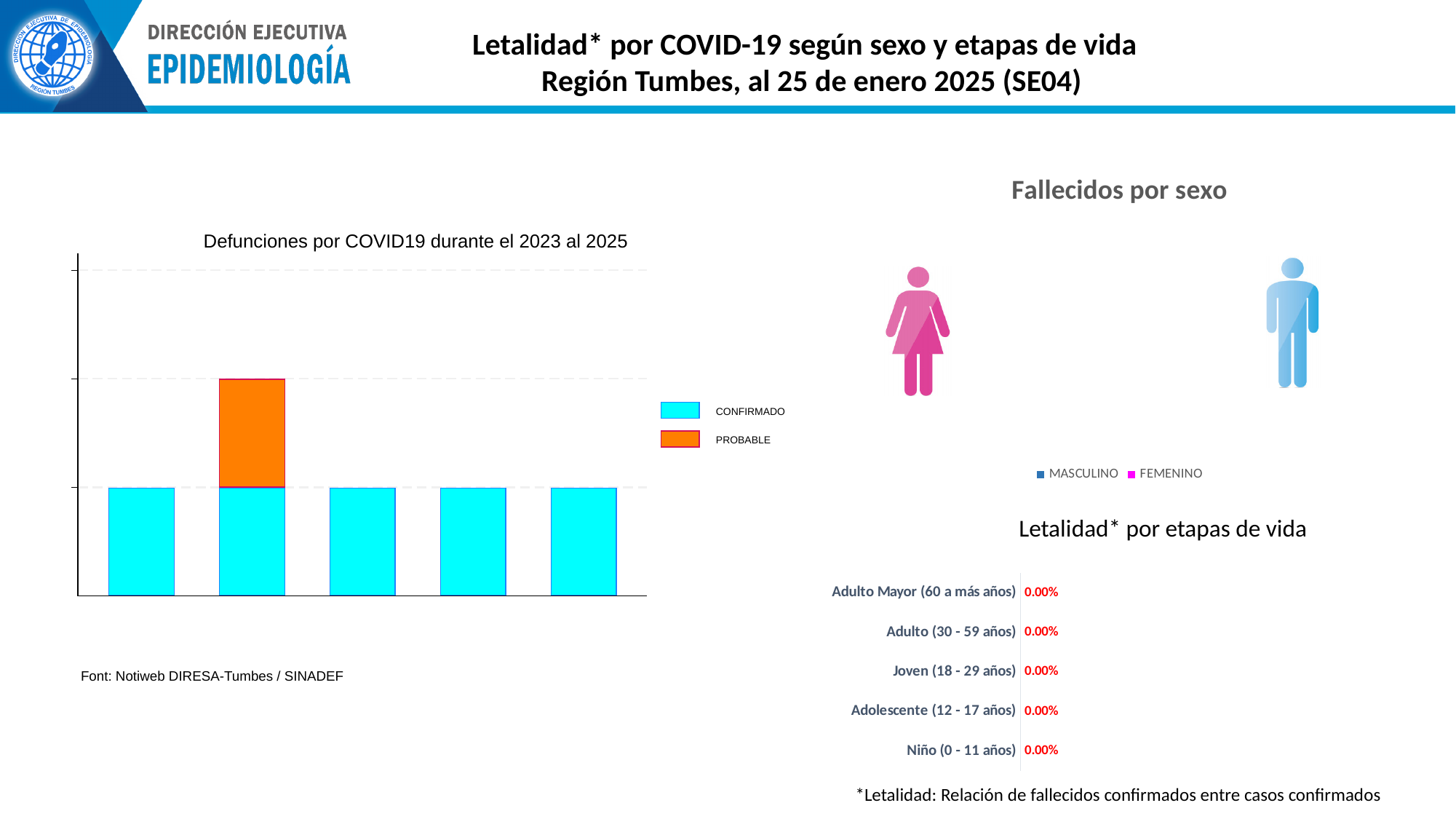
In the chart titled "Letalidad* por etapas de vida", what is the value for Adulto Mayor (60 a más años)? 0.00% In the chart titled "Defunciones por COVID19 durante el 2023 al 2025", which series is shown in orange? PROBABLE In the chart titled "Fallecidos por sexo", how many series does the legend list? 2 In the chart titled "Defunciones por COVID19 durante el 2023 al 2025", how many bars are plotted? 5 In the chart titled "Letalidad* por etapas de vida", what is the difference between the values for Adulto (30 - 59 años) and Adolescente (12 - 17 años)? 0.00% In the chart titled "Defunciones por COVID19 durante el 2023 al 2025", which bar from the left is the tallest? The second bar In the chart titled "Letalidad* por etapas de vida", how many age-stage categories are listed? 5 In the chart titled "Defunciones por COVID19 durante el 2023 al 2025", which series is shown in cyan? CONFIRMADO In the chart titled "Defunciones por COVID19 durante el 2023 al 2025", how many series does the legend list? 2 In the chart titled "Letalidad* por etapas de vida", what is the value for Niño (0 - 11 años)? 0.00% In the chart titled "Letalidad* por etapas de vida", what is the value for Joven (18 - 29 años)? 0.00% In the chart titled "Defunciones por COVID19 durante el 2023 al 2025", what kind of chart is shown? Bar chart